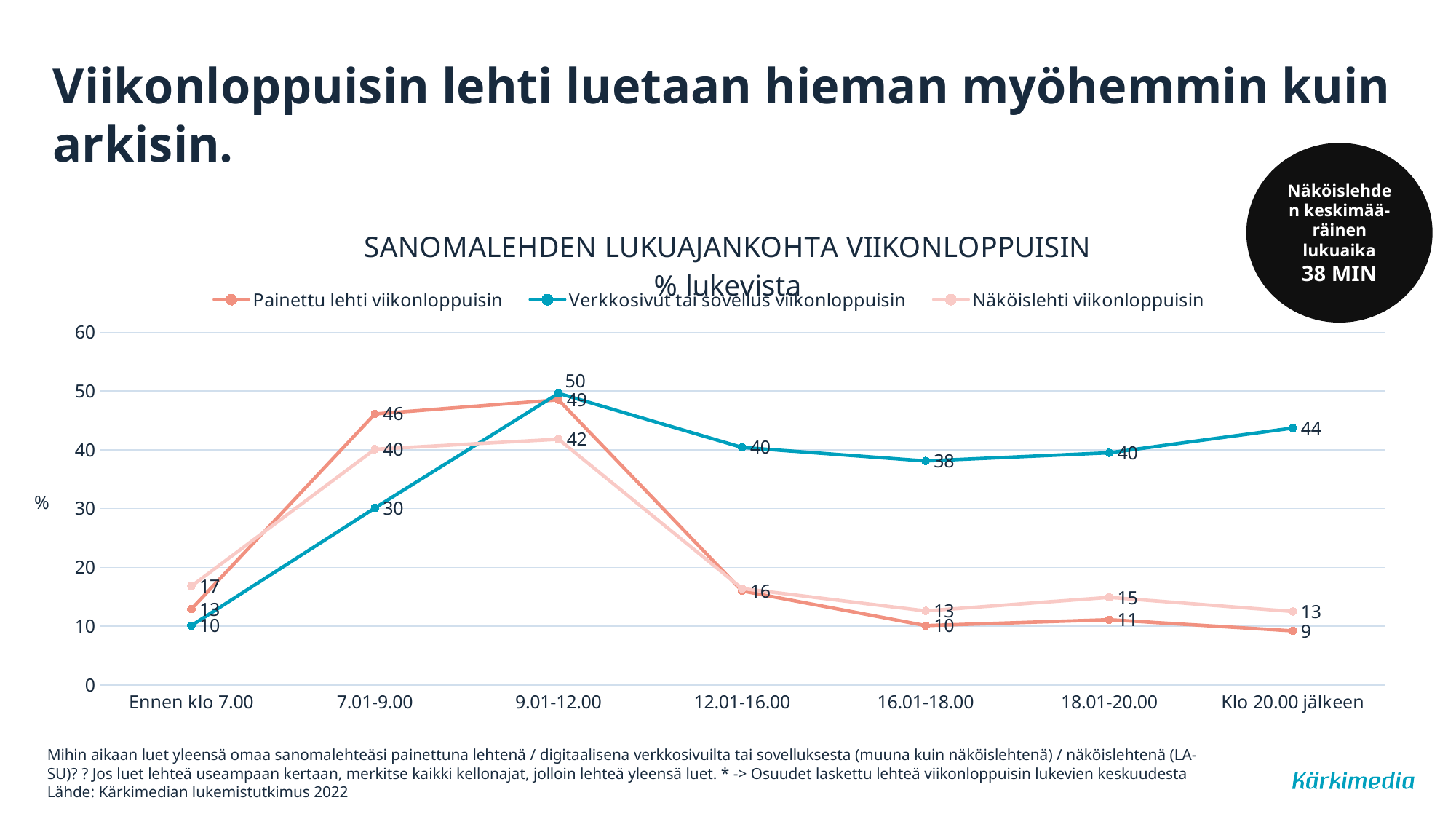
How many series does the legend list? 3 What is the value for Näköislehti viikonloppuisin at Ennen klo 7.00? 17 How many time-of-day categories are shown on the x axis? 7 What is the value for Verkkosivut tai sovellus viikonloppuisin at 9.01-12.00? 50 What is the value for Verkkosivut tai sovellus viikonloppuisin at 16.01-18.00? 38 What is the value for Painettu lehti viikonloppuisin at 7.01-9.00? 46 At which time slot does Painettu lehti viikonloppuisin have its lowest value? Klo 20.00 jälkeen What type of chart is shown on the slide? line chart At Klo 20.00 jälkeen, what is the difference between Verkkosivut tai sovellus viikonloppuisin and Painettu lehti viikonloppuisin? 35 At which time slot does Verkkosivut tai sovellus viikonloppuisin reach its highest value? 9.01-12.00 At 7.01-9.00, which is larger: Painettu lehti viikonloppuisin or Verkkosivut tai sovellus viikonloppuisin? Painettu lehti viikonloppuisin According to the black circle on the slide, what is the average reading time of the näköislehti? 38 MIN